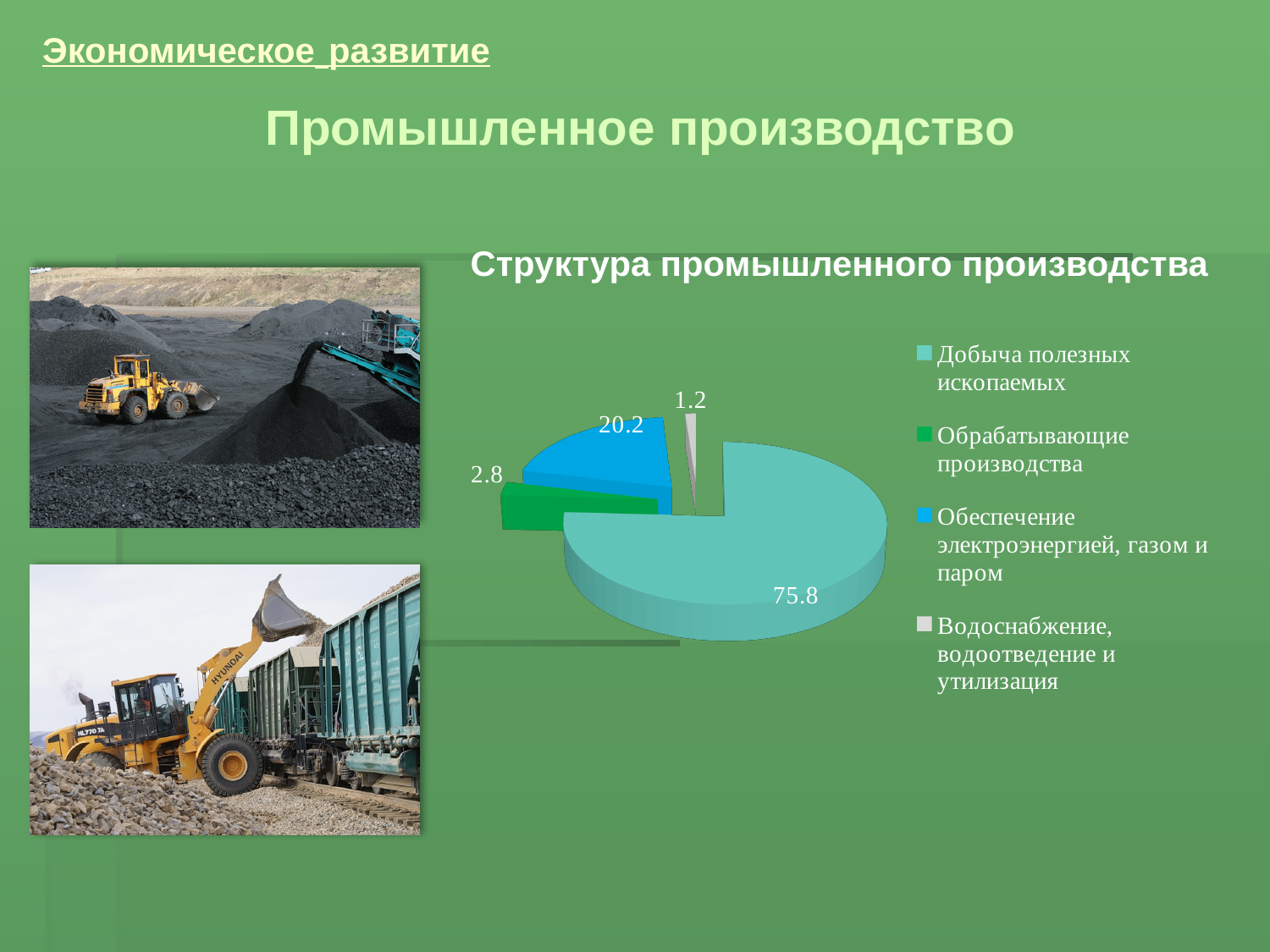
What is the value shown for "Обрабатывающие производства" in the pie chart? 2.8 What is the value shown for "Обеспечение электроэнергией, газом и паром" in the pie chart? 20.2 What kind of chart is shown under the title "Структура промышленного производства"? Pie chart What is the title of the pie chart? Структура промышленного производства Which category has the smallest slice in the pie chart? Водоснабжение, водоотведение и утилизация How many categories does the pie chart legend list? 4 What colour is the slice for "Обрабатывающие производства" in the pie chart? Green Which is larger in the pie chart: "Обрабатывающие производства" or "Обеспечение электроэнергией, газом и паром"? Обеспечение электроэнергией, газом и паром What is the difference between the values for "Добыча полезных ископаемых" and "Обеспечение электроэнергией, газом и паром"? 55.6 What is the value shown for "Водоснабжение, водоотведение и утилизация" in the pie chart? 1.2 Which category has the largest slice in the pie chart? Добыча полезных ископаемых What is the value shown for "Добыча полезных ископаемых" in the pie chart? 75.8